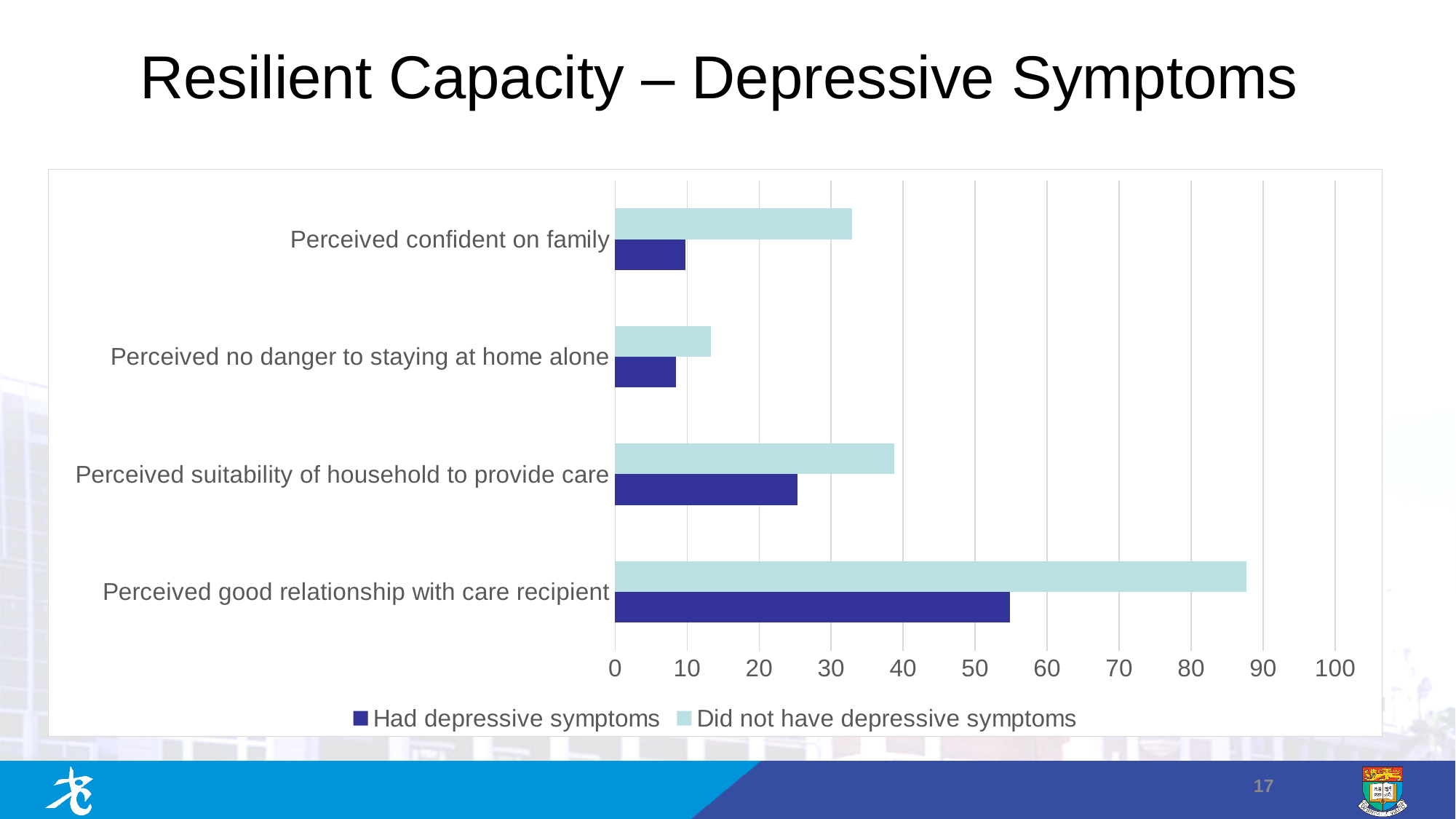
Is the value for Had depressive symptoms for Perceived good relationship with care recipient greater or less than 50? greater Is the value for Did not have depressive symptoms for Perceived good relationship with care recipient greater or less than 80? greater Is the value for Did not have depressive symptoms for Perceived no danger to staying at home alone greater or less than 20? less Which category has the lowest value for Had depressive symptoms? Perceived no danger to staying at home alone What kind of chart is shown on the slide? bar chart Which category has the highest value for Did not have depressive symptoms? Perceived good relationship with care recipient For Perceived suitability of household to provide care, which series has the larger value: Had depressive symptoms or Did not have depressive symptoms? Did not have depressive symptoms Which category has the lowest value for Did not have depressive symptoms? Perceived no danger to staying at home alone How many categories are shown on the chart? 4 How many series does the legend list? 2 Which series is shown in dark blue in the legend? Had depressive symptoms